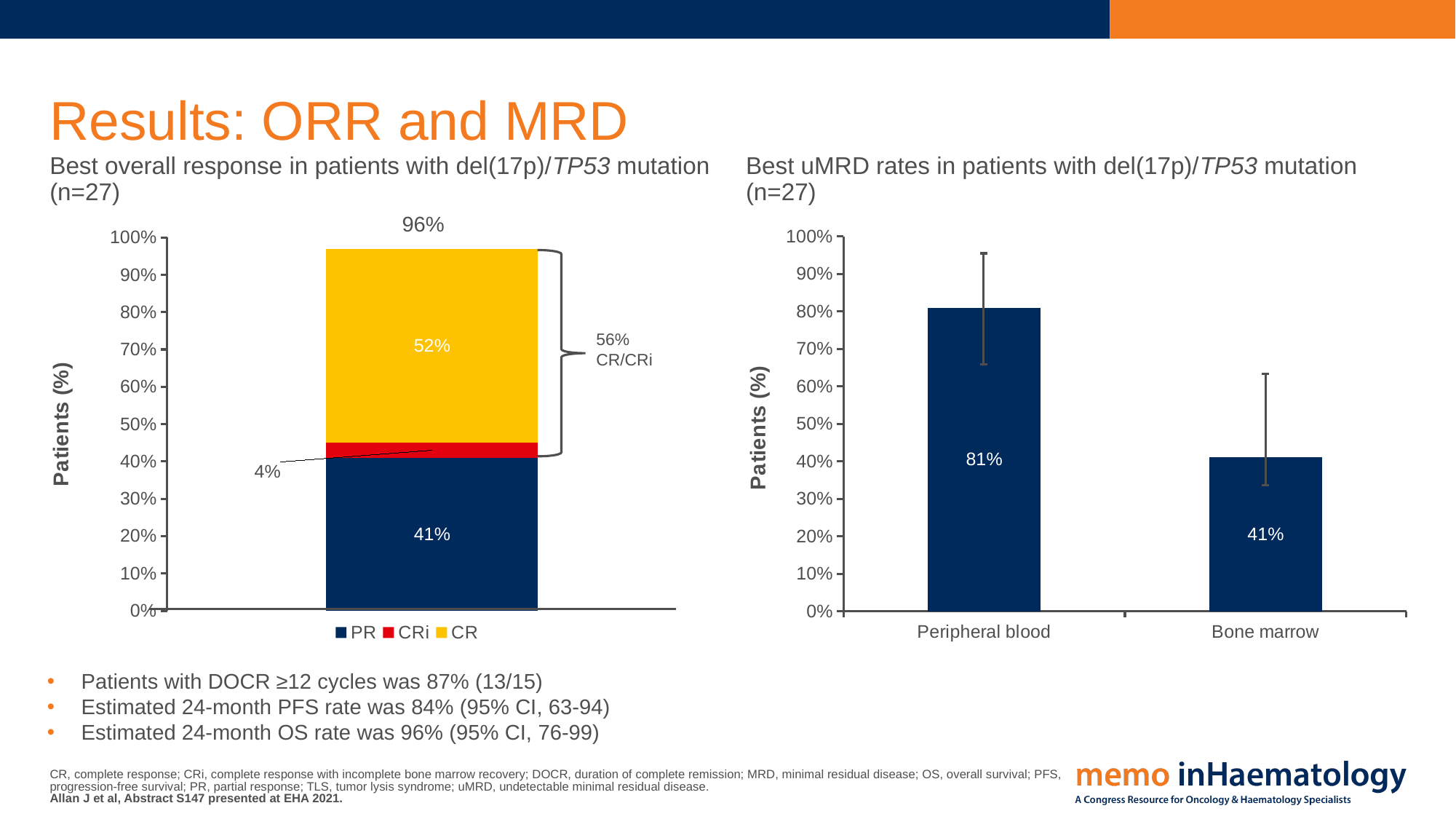
In the 'Best overall response' chart on the left, what percentage of patients had a CR? 52% In the 'Best uMRD rates' chart on the right, what is the uMRD rate in peripheral blood? 81% In the 'Best uMRD rates' chart on the right, what is the uMRD rate in bone marrow? 41% In the 'Best overall response' chart on the left, what is the combined CR/CRi rate indicated by the bracket? 56% In the 'Best uMRD rates' chart on the right, what is the difference between the peripheral blood and bone marrow uMRD rates? 40% In the 'Best uMRD rates' chart on the right, how many categories are shown on the x axis? 2 In the 'Best overall response' chart on the left, what percentage of patients had a PR? 41% What type of chart is the 'Best uMRD rates' chart on the right? Bar chart In the 'Best overall response' chart on the left, how many series does the legend list? 3 In the 'Best overall response' chart on the left, what percentage of patients had a CRi? 4% In the 'Best overall response' chart on the left, which response category has the largest share of the bar? CR In the 'Best overall response' chart on the left, what is the total shown at the top of the stacked bar? 96%